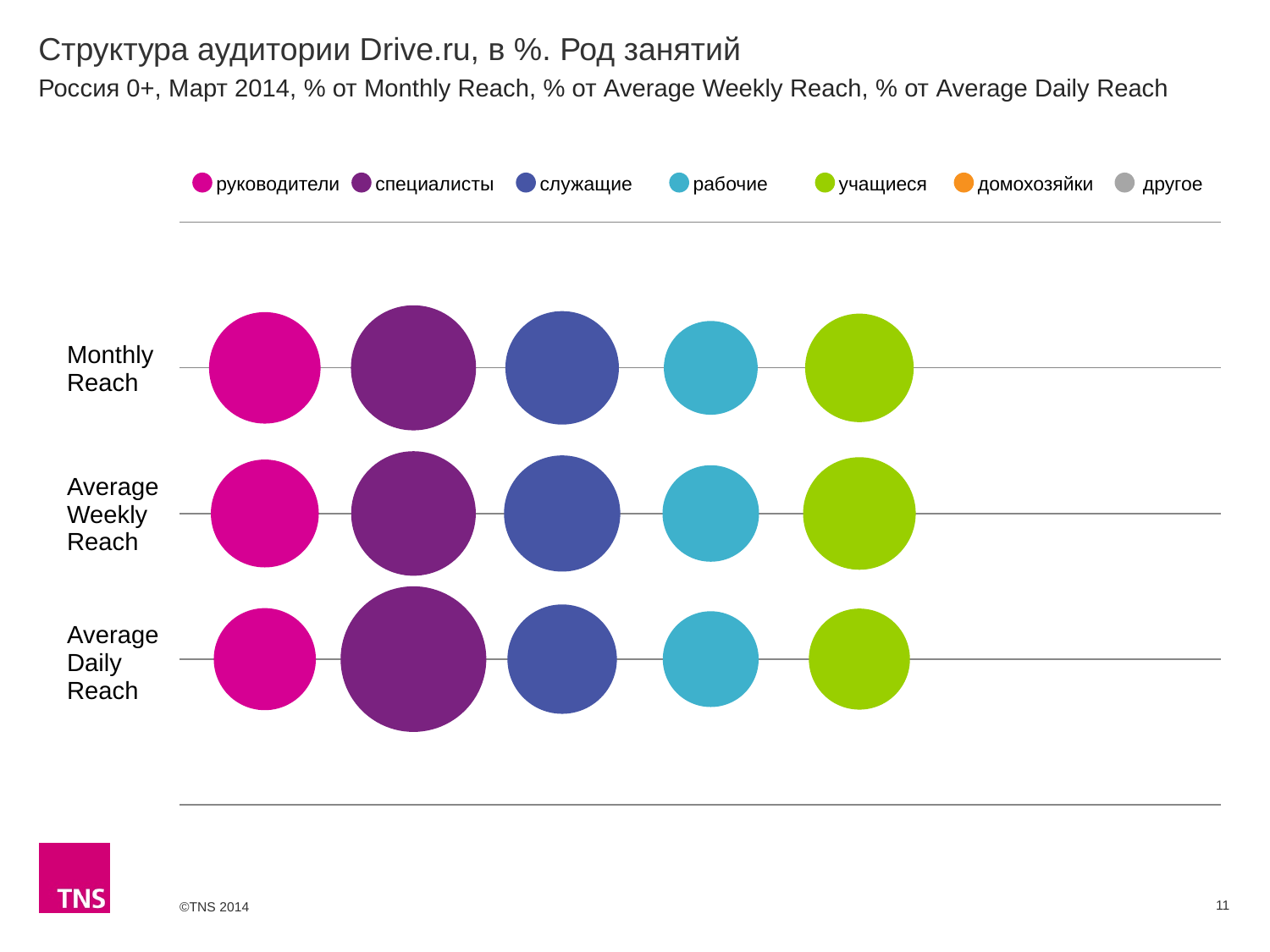
Which legend entry is shown in pink (the first entry)? руководители How many reach categories (rows) are plotted on the chart? 3 Among the visible bubbles in the Monthly Reach row, which occupation group has the smallest bubble? рабочие In the Average Daily Reach row, which bubble is larger: специалисты or рабочие? специалисты How many series does the legend list? 7 In the Average Daily Reach row, which occupation group has the largest bubble? специалисты What is the title of the slide? Структура аудитории Drive.ru, в %. Род занятий What kind of chart is shown on the slide? Bubble chart Among the visible bubbles in the Average Daily Reach row, which occupation group has the smallest bubble? рабочие In the Average Weekly Reach row, which bubble is larger: специалисты or рабочие? специалисты In the Monthly Reach row, which occupation group has the largest bubble? специалисты Which two legend groups have no visible bubble in any row? домохозяйки and другое